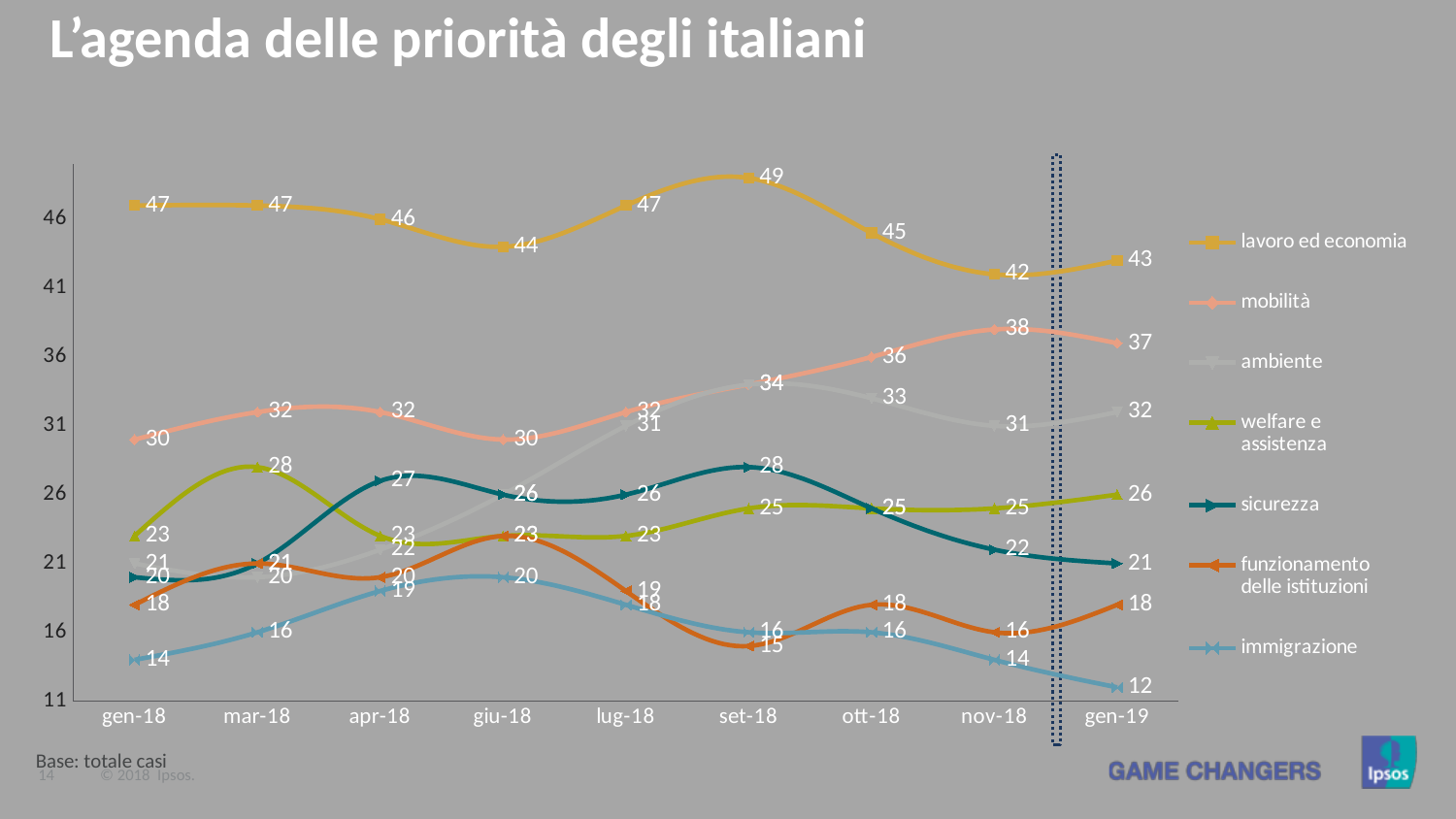
At gen-19, which is higher: mobilità or ambiente? mobilità What is the value for immigrazione at gen-19? 12 At which date does immigrazione reach its lowest value? gen-19 What is the value for mobilità at nov-18? 38 At which date does lavoro ed economia reach its highest value? set-18 How many series does the legend list? 7 How many dates are shown on the x axis? 9 What is the value for lavoro ed economia at set-18? 49 What is the title of the slide? L'agenda delle priorità degli italiani Does the immigrazione series rise or fall from set-18 to gen-19? fall What kind of chart is shown on the slide? line chart By how much did lavoro ed economia fall from gen-18 to gen-19? 4